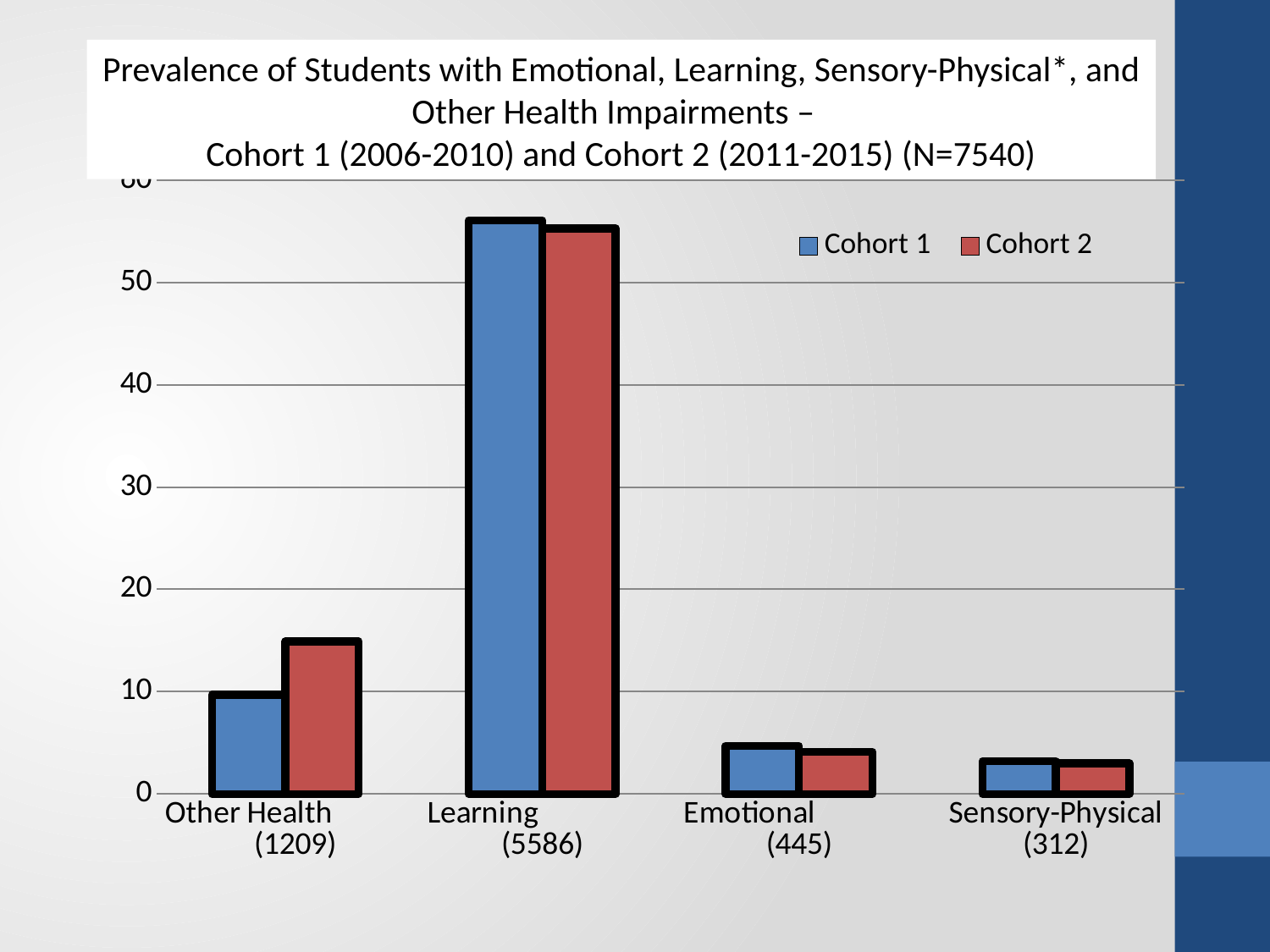
How many categories are shown on the x axis? 4 How many series does the legend list? 2 What colour are the Cohort 2 bars? red Which category has the highest value for Cohort 1? Learning For Other Health, which is larger: the Cohort 1 value or the Cohort 2 value? Cohort 2 Is the Cohort 1 value for Emotional greater or less than 10? less What kind of chart is shown on the slide? bar chart Is the Cohort 2 value for Other Health greater or less than 10? greater What are the two entries in the chart's legend? Cohort 1 and Cohort 2 Is the Cohort 1 value for Learning greater or less than 50? greater Which category has the lowest value for Cohort 2? Sensory-Physical